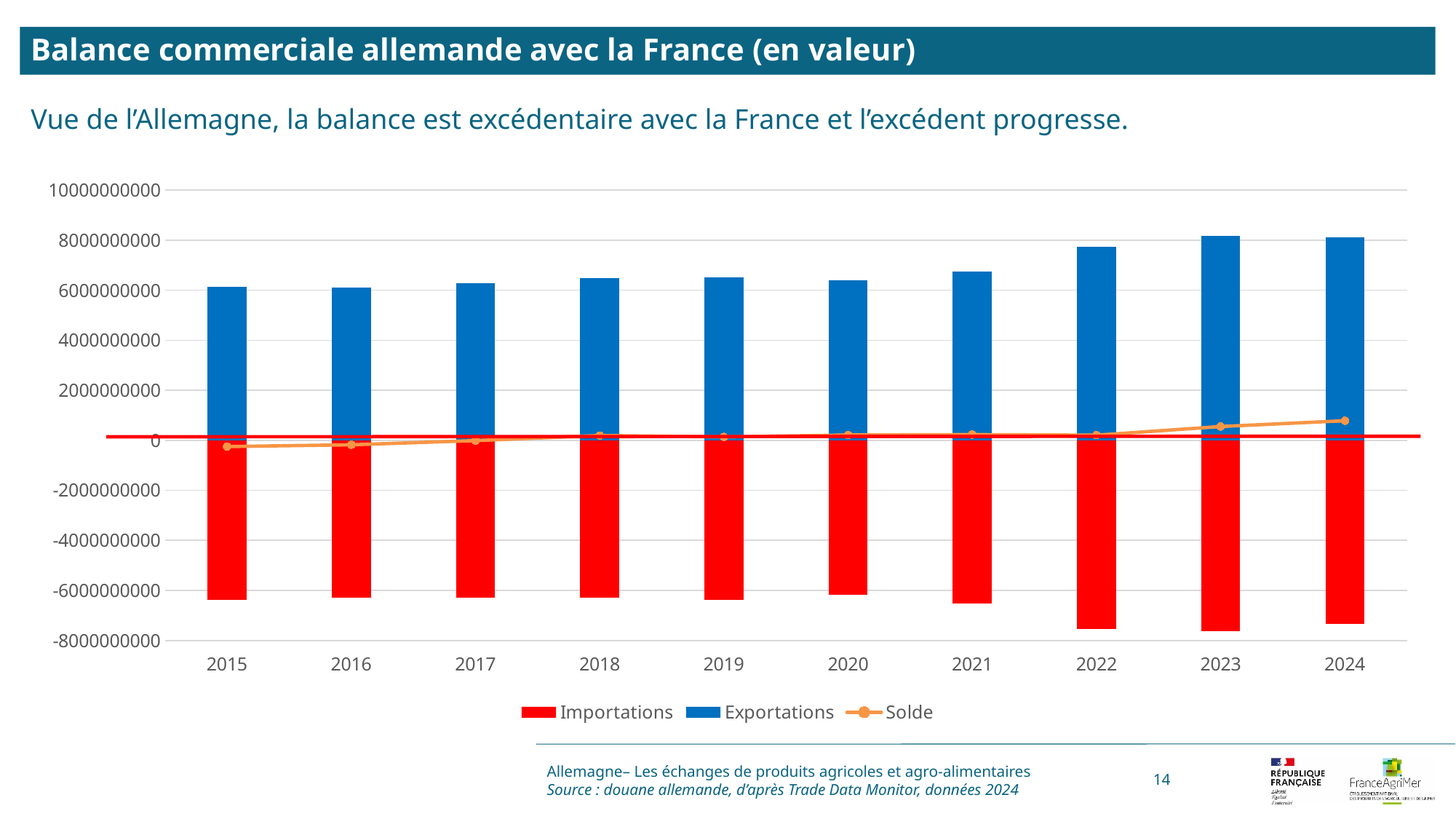
How many series does the chart legend list? 3 Is the Solde value for 2024 greater or less than 0? greater What is the title of the chart on the slide? Balance commerciale allemande avec la France (en valeur) Which is larger, the Exportations value for 2022 or for 2019? 2022 Is the Importations value for 2022 greater or less than -6000000000? less Which colour represents Exportations in the chart? Blue In which year is the Solde value highest? 2024 Is the Exportations value for 2022 greater or less than 8000000000? less What kind of chart is shown on the slide? Bar chart with a line series How many years are shown on the x axis of the chart? 10 Does the Solde line rise or fall from 2015 to 2024? Rises